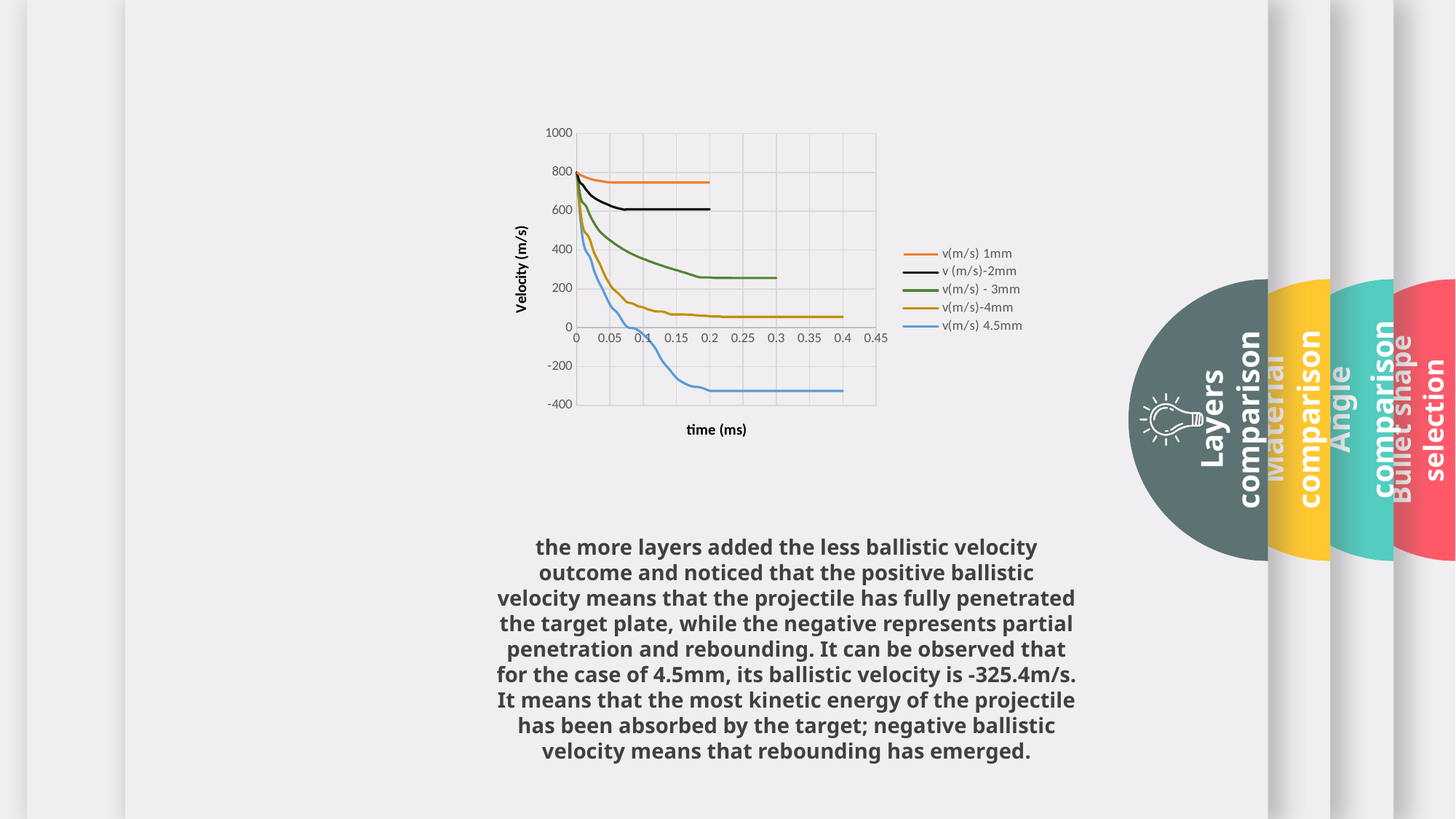
How many series does the chart's legend list? 5 Which series has the larger final velocity, v (m/s)-2mm or v(m/s)-4mm? v (m/s)-2mm What is the title of the vertical axis of the chart? Velocity (m/s) Which series ends at the lowest velocity at the end of its curve? v(m/s) 4.5mm Is the final velocity of the v(m/s) 4.5mm series greater or less than -200? less Do the velocity values rise or fall as time increases along the x axis? fall What kind of chart is shown on the slide? line chart What is the title of the horizontal axis of the chart? time (ms) Is the final velocity of the v(m/s) 1mm series greater or less than 600? greater Is the final velocity of the v(m/s) - 3mm series greater or less than 400? less Which series ends at the highest velocity at the end of its curve? v(m/s) 1mm